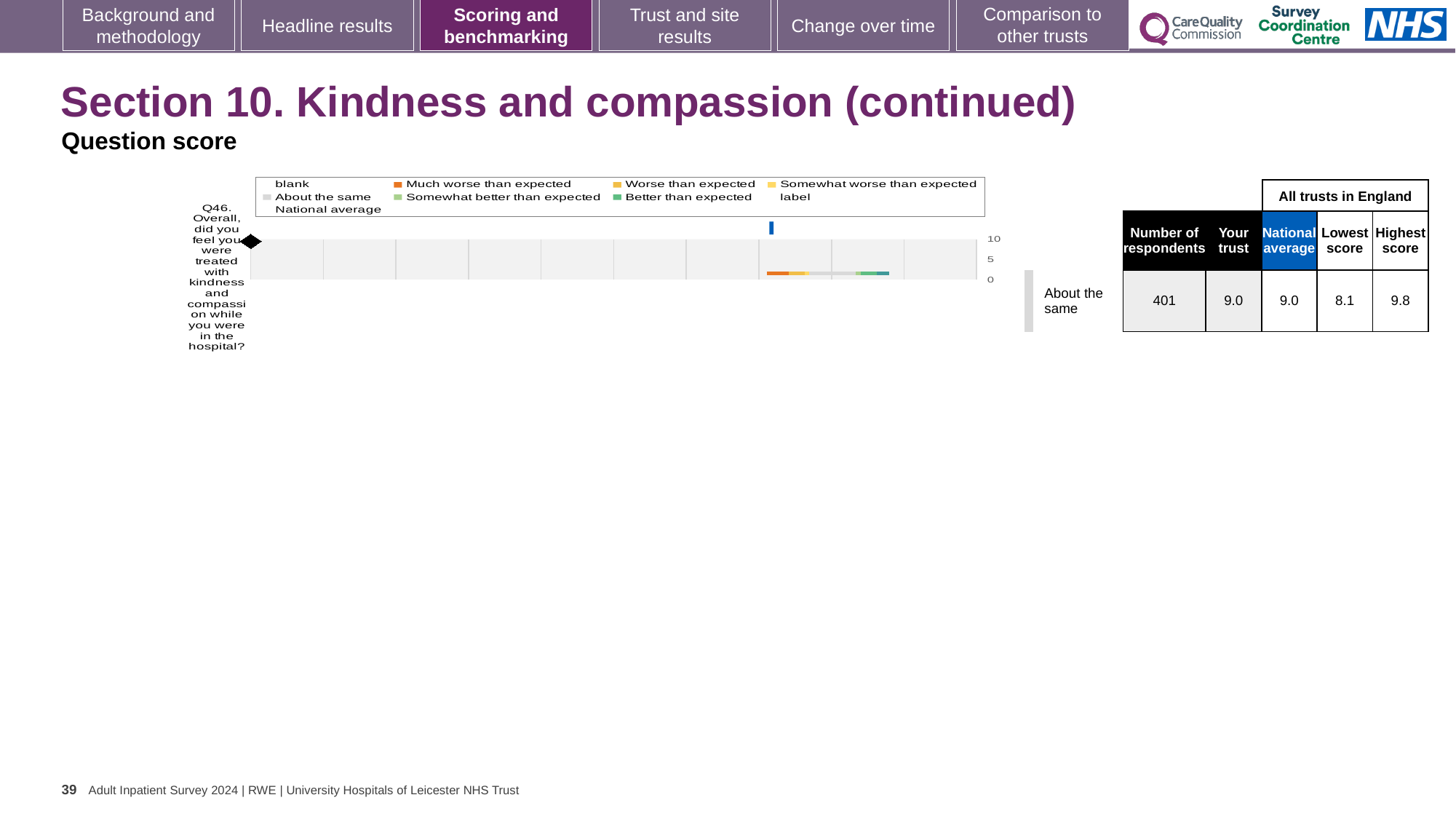
What is the 'Your trust' score for Q46? 9.0 Is the 'Your trust' score for Q46 greater or less than 5? greater Which question is plotted on the chart? Q46. Overall, did you feel you were treated with kindness and compassion while you were in the hospital? What is the lowest score among all trusts in England for Q46? 8.1 How many respondents answered Q46? 401 What is the difference between the highest score and the lowest score for Q46? 1.7 What is the highest score among all trusts in England for Q46? 9.8 What kind of chart is shown on the slide? bar chart How many survey questions are plotted on the chart? 1 What is the national average score for Q46? 9.0 Which is larger for Q46, the highest score or the lowest score? Highest score What is the highest tick value shown on the chart's score axis? 10